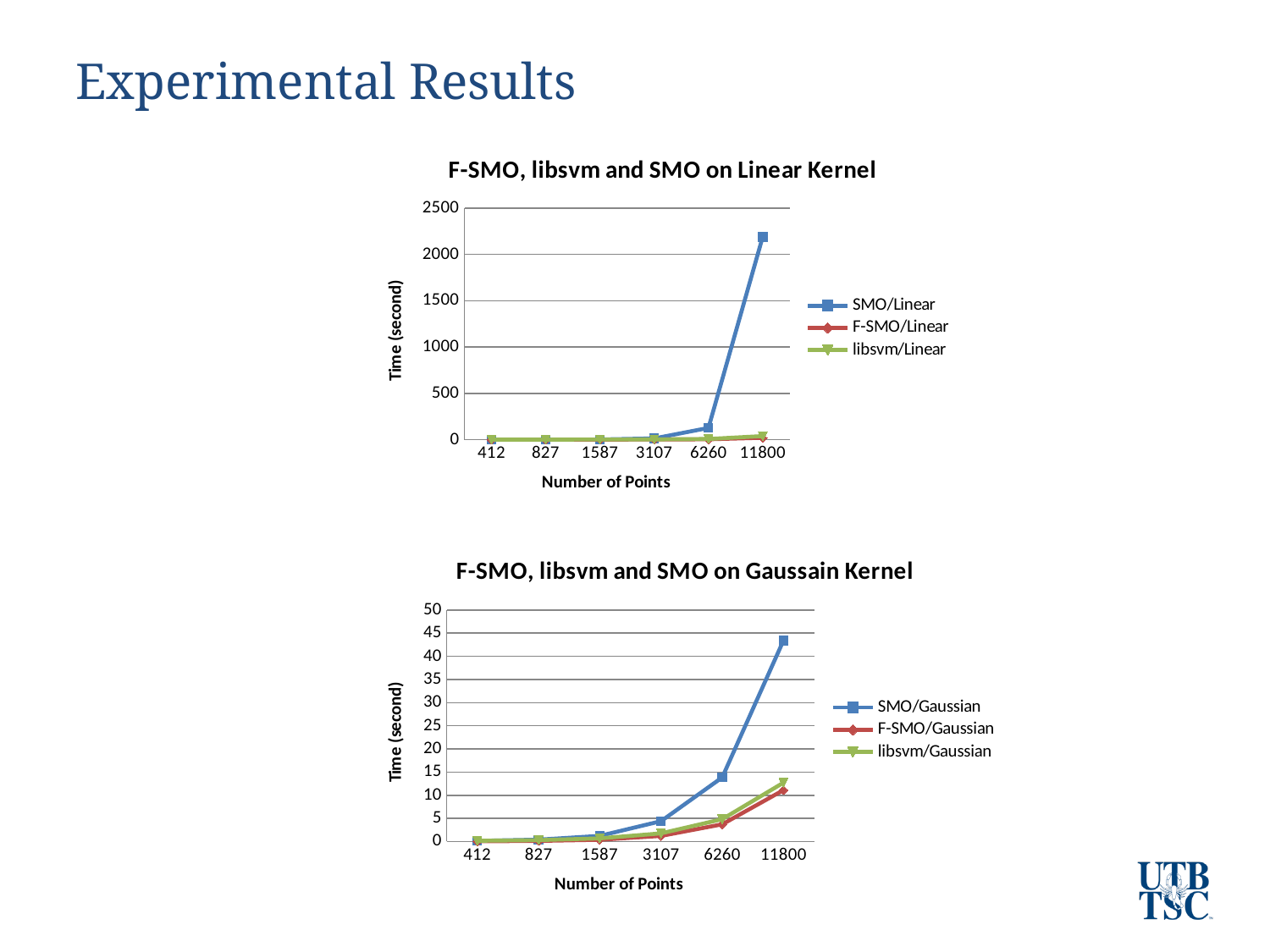
How many Number of Points categories are shown on the x axis of the 'F-SMO, libsvm and SMO on Linear Kernel' chart? 6 How many series does the legend of the 'F-SMO, libsvm and SMO on Gaussain Kernel' chart list? 3 In the 'F-SMO, libsvm and SMO on Linear Kernel' chart, is the value for SMO/Linear at 11800 points greater or less than 2000? greater In the 'F-SMO, libsvm and SMO on Gaussain Kernel' chart, is the value for libsvm/Gaussian at 11800 points greater or less than 10? greater In the 'F-SMO, libsvm and SMO on Gaussain Kernel' chart, is the value for SMO/Gaussian at 11800 points greater or less than 40? greater What type of chart is the 'F-SMO, libsvm and SMO on Linear Kernel' chart? line chart In the 'F-SMO, libsvm and SMO on Linear Kernel' chart, which series has the highest value at 11800 points? SMO/Linear In the 'F-SMO, libsvm and SMO on Gaussain Kernel' chart, does the SMO/Gaussian series rise or fall as the number of points increases? rise In the 'F-SMO, libsvm and SMO on Gaussain Kernel' chart, which is larger at 11800 points: SMO/Gaussian or F-SMO/Gaussian? SMO/Gaussian What is the y-axis label of the 'F-SMO, libsvm and SMO on Linear Kernel' chart? Time (second)